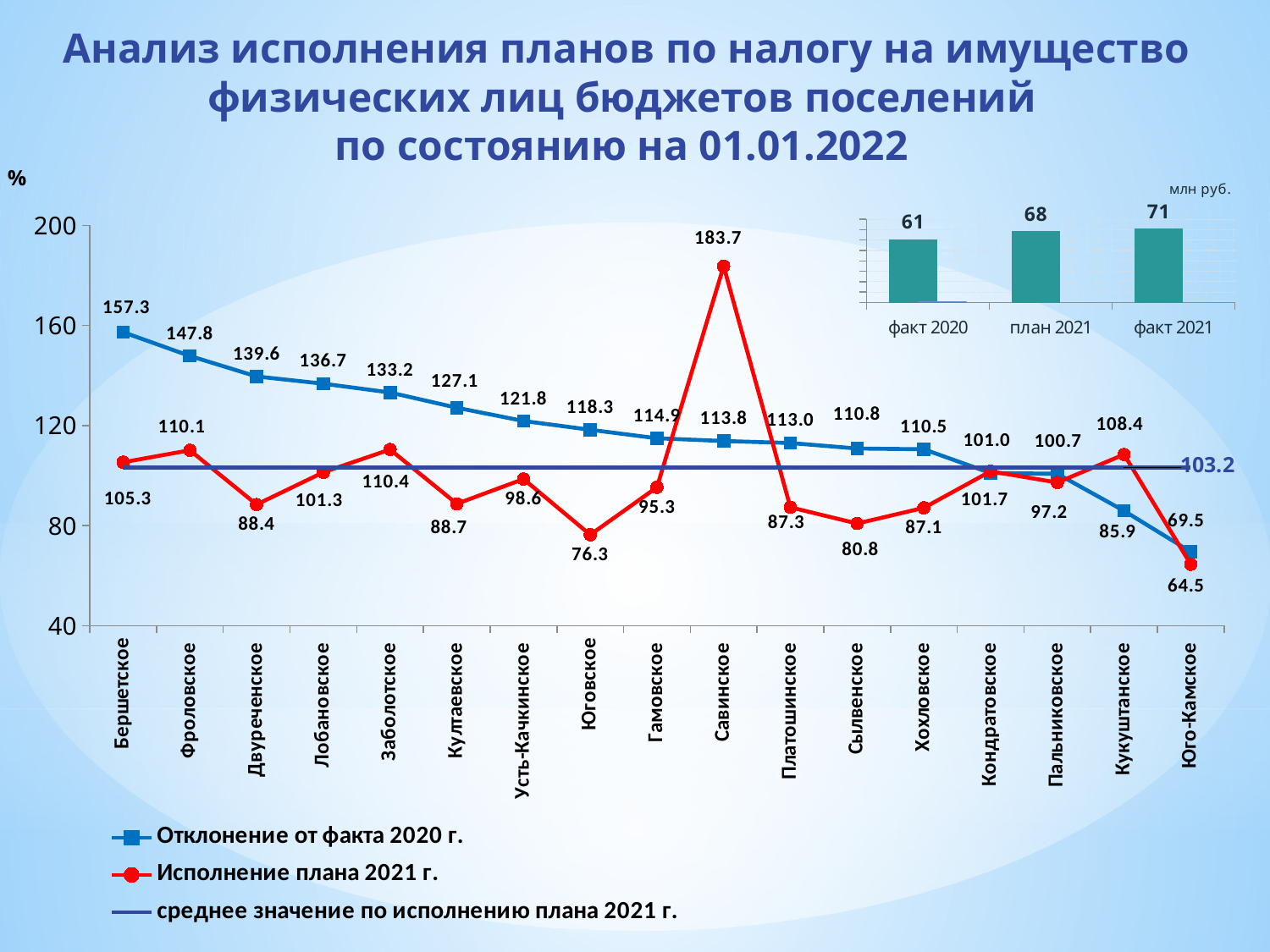
How many settlements are shown on the x axis of the main line chart? 17 On the small bar chart in the top right, what is the difference between 'план 2021' and 'факт 2020'? 7 On the main line chart, which is larger for Кондратовское: 'Отклонение от факта 2020 г.' or 'Исполнение плана 2021 г.'? Исполнение плана 2021 г. On the main line chart, what is the difference between the 'Отклонение от факта 2020 г.' values for Бершетское and Фроловское? 9.5 How many series does the legend of the main line chart list? 3 On the main line chart, what is the value of 'Исполнение плана 2021 г.' for Савинское? 183.7 On the main line chart, what is the value of 'Отклонение от факта 2020 г.' for Бершетское? 157.3 On the main line chart, which settlement has the highest value for 'Отклонение от факта 2020 г.'? Бершетское On the main line chart, which settlement has the lowest value for 'Исполнение плана 2021 г.'? Юго-Камское On the main line chart, what is the value of the average line 'среднее значение по исполнению плана 2021 г.'? 103.2 On the main line chart, does the 'Отклонение от факта 2020 г.' series rise or fall from Бершетское to Юго-Камское? fall On the small bar chart in the top right, what is the value for 'факт 2021'? 71